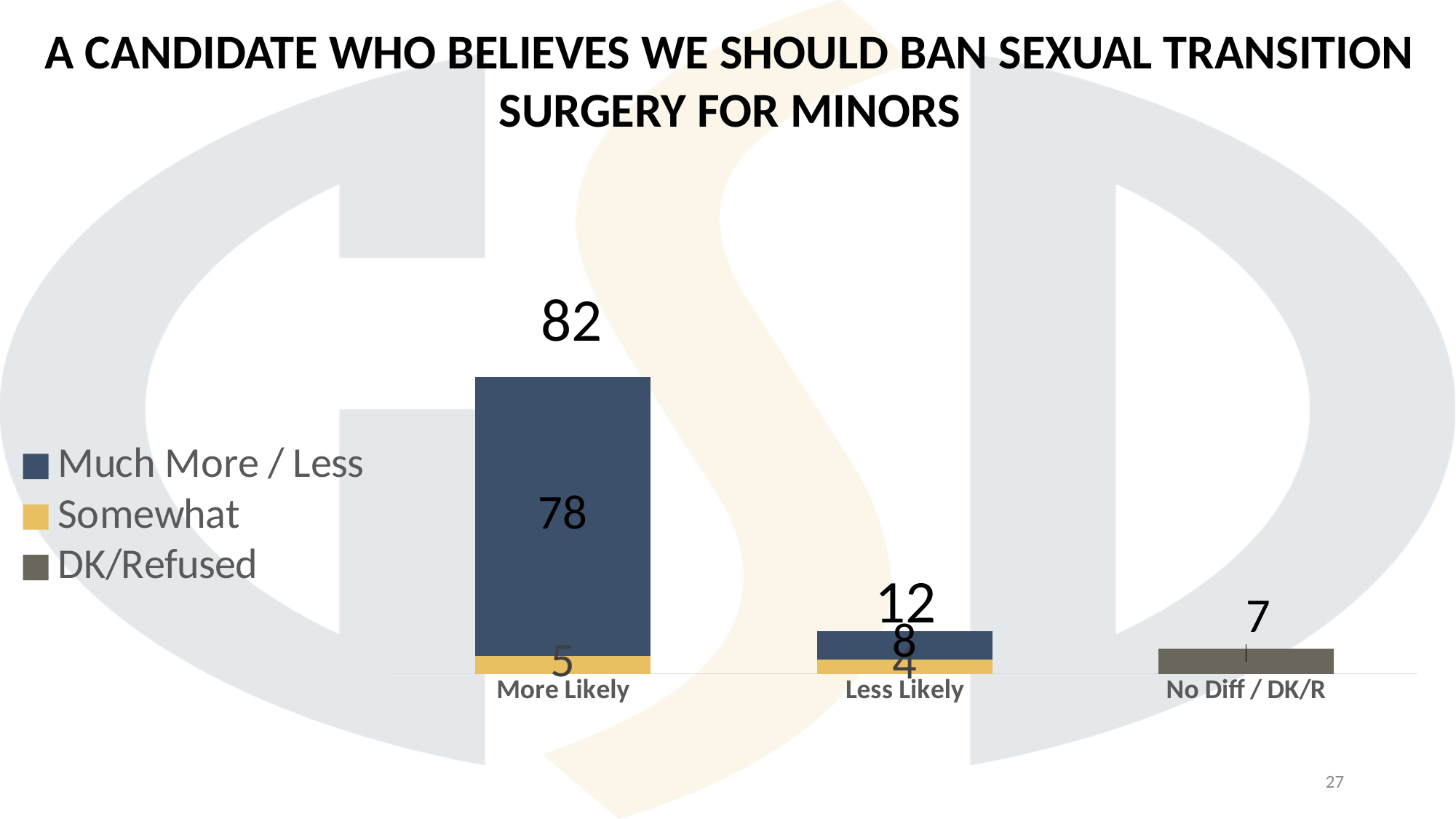
What kind of chart is shown? Stacked bar chart How many series does the legend list? 3 What is the value for No Diff / DK/R? 7 What is the value of the Somewhat segment for Less Likely? 4 Which is larger: the Less Likely total or the No Diff / DK/R value? Less Likely total What is the value of the Much More / Less segment for Less Likely? 8 Which category has the highest total? More Likely What is the difference between the Much More / Less values for More Likely and Less Likely? 70 What is the value of the Much More / Less segment for More Likely? 78 What is the value of the Somewhat segment for More Likely? 5 What is the total shown above the More Likely bar? 82 What is the total shown above the Less Likely bar? 12